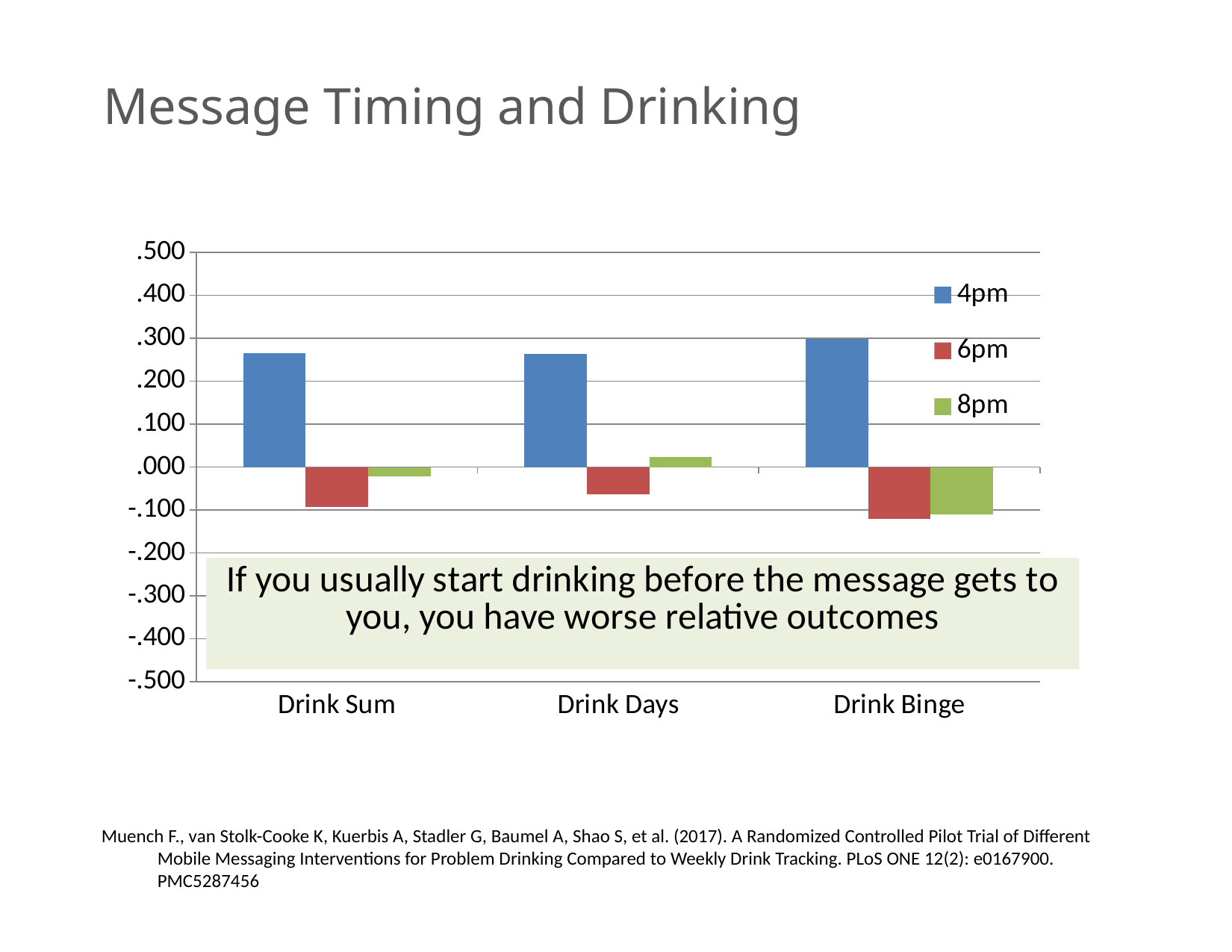
Is the 4pm value for Drink Sum greater or less than .200? greater Which is larger, the 6pm value for Drink Days or the 6pm value for Drink Binge? Drink Days How many categories are shown on the x axis? 3 Which series does the legend list first? 4pm What kind of chart is shown on the slide? bar chart How many series does the legend list? 3 Is the 6pm value for Drink Days greater or less than -.100? greater Which category has the highest 4pm value? Drink Binge Which category has the lowest 6pm value? Drink Binge Which series has the highest value for Drink Days? 4pm Is the 8pm value for Drink Days greater or less than .000? greater